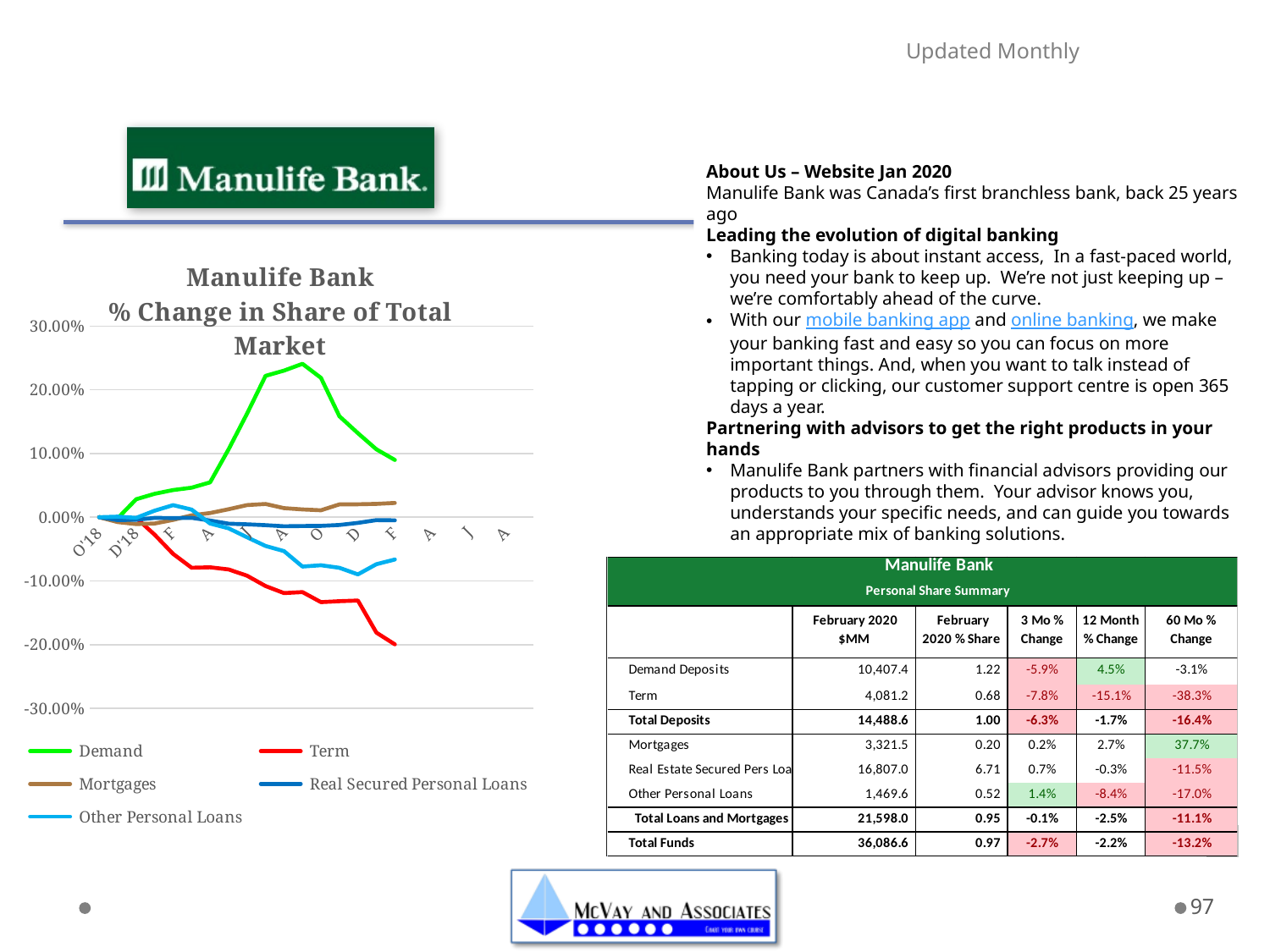
Which series is plotted in green? Demand Is the peak value of the Demand series greater or less than 20.00%? greater What kind of chart is shown on the slide? line chart Is the final value of the Term series greater or less than -10.00%? less What is the title of the chart? Manulife Bank % Change in Share of Total Market What colour is the Term series line in the legend? red Does the Term series generally rise or fall along the x axis? fall Which series reaches the highest value on the chart? Demand Which series reaches the lowest value on the chart? Term How many series does the chart legend list? 5 Is the highest value of the Mortgages series greater or less than 10.00%? less At the last plotted point, which series is larger, Demand or Term? Demand